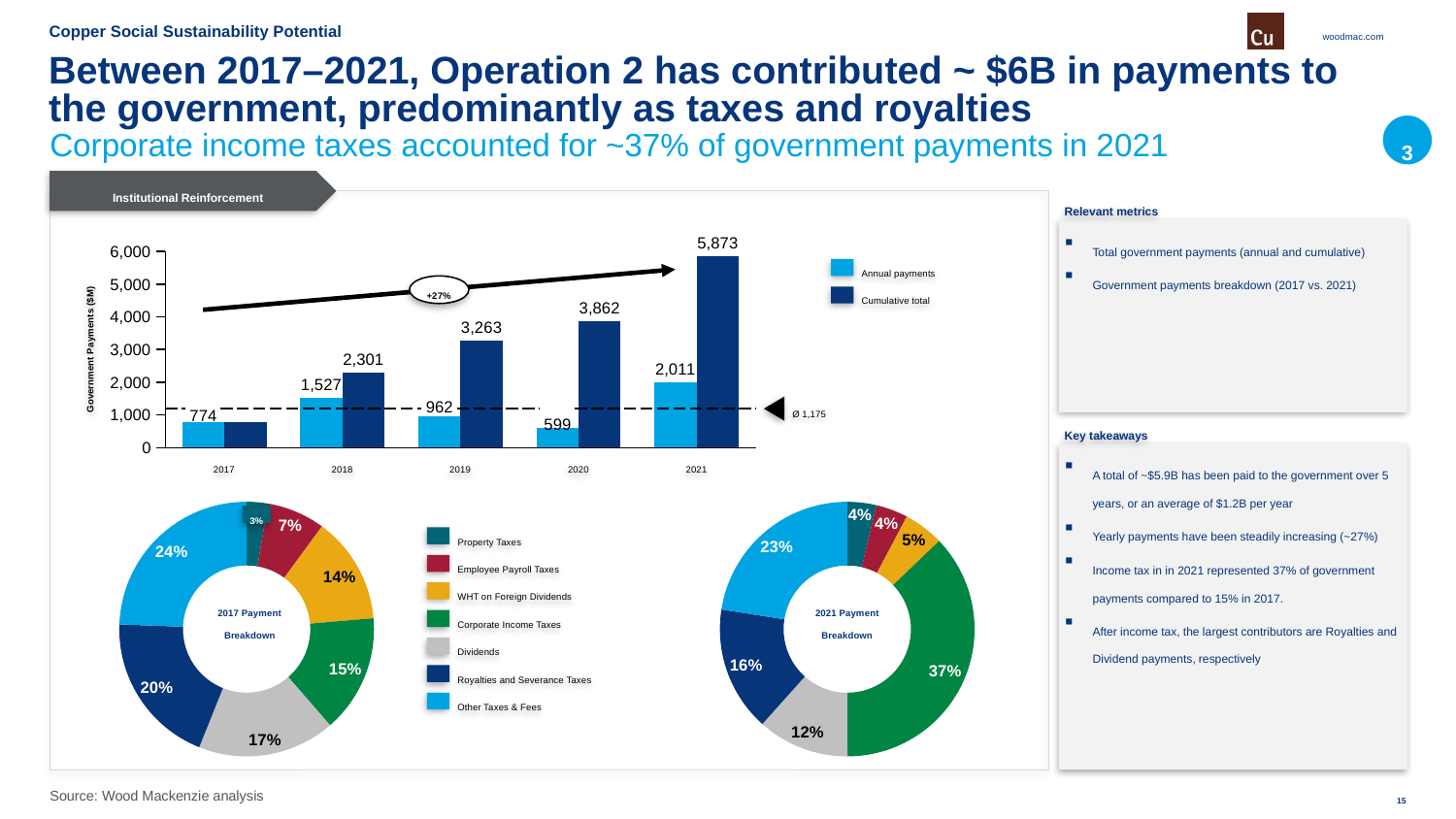
In the bar chart of government payments, what value is marked by the dashed average line? Ø 1,175 In the bar chart of government payments, what is the cumulative total for 2020? 3,862 In the bar chart of government payments, what is the difference between the annual payments for 2018 and 2019? 565 In the bar chart of government payments, how many series does the legend list? 2 In the bar chart of government payments, which year has the highest annual payment? 2021 In the 2017 Payment Breakdown chart, what share is Dividends? 17% In the bar chart of government payments, what is the annual payment value for 2021? 2,011 In the bar chart of government payments, which year has the lowest annual payment? 2020 In the bar chart of government payments, is the annual payment for 2018 larger or smaller than the annual payment for 2019? larger In the 2021 Payment Breakdown chart, what share is Corporate Income Taxes? 37% What kind of chart is the 2021 Payment Breakdown? Pie (donut) chart In the 2017 Payment Breakdown chart, which category has the smallest share? Property Taxes